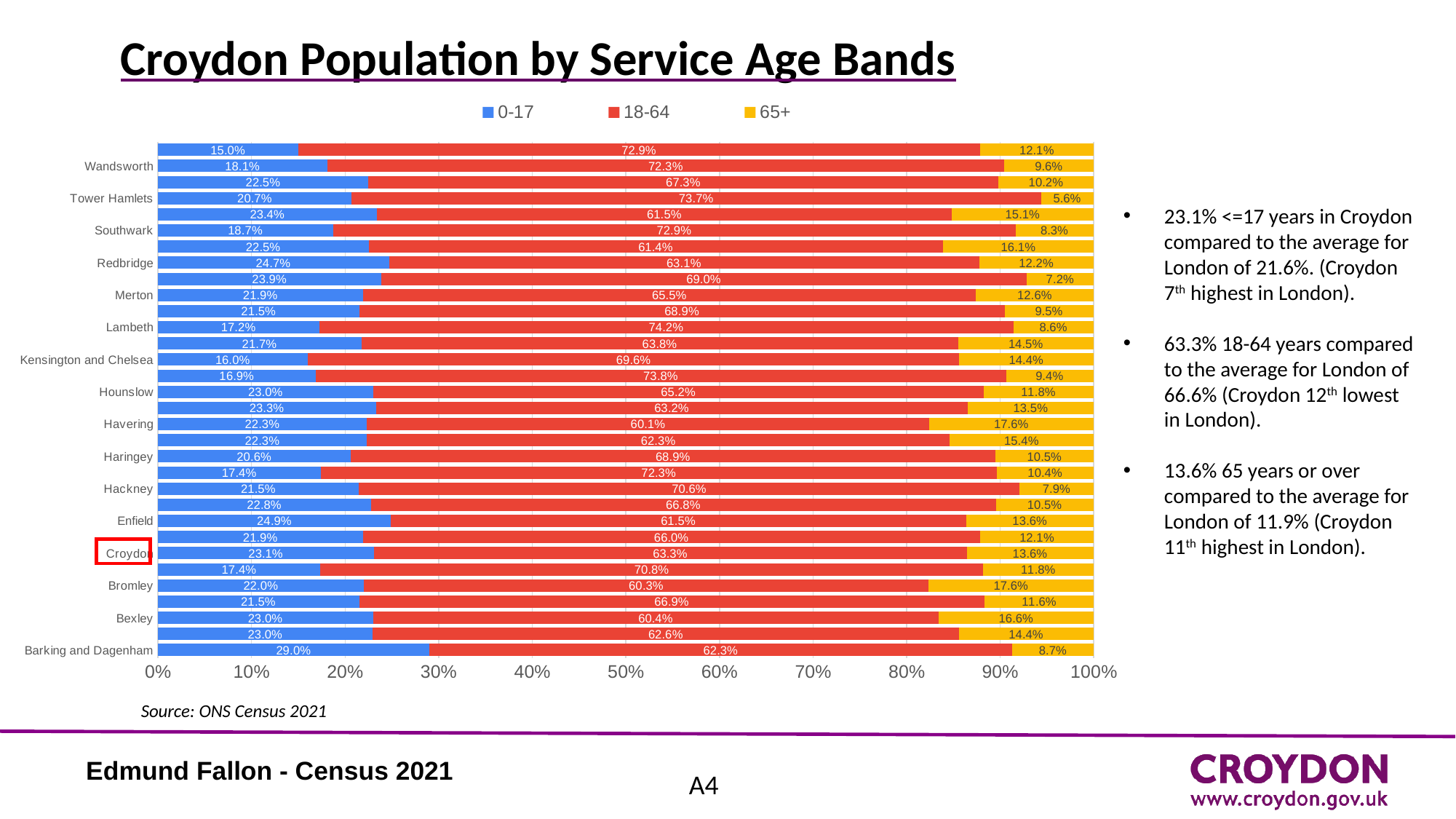
Which borough has the highest 0-17 share? Barking and Dagenham What is the difference between the 0-17 values for Enfield and Kensington and Chelsea? 8.9% Which series is shown in yellow in the legend? 65+ What is the difference between the 65+ values for Bexley and Hackney? 8.7% What is the 65+ value for Havering? 17.6% Which borough has the lowest 65+ share? Tower Hamlets What is the 0-17 value for Croydon? 23.1% What is the 0-17 value for Barking and Dagenham? 29.0% What is the 18-64 value for Tower Hamlets? 73.7% What kind of chart is shown on the slide? Stacked bar chart How many series does the legend list? 3 Which has a larger 18-64 share, Lambeth or Bromley? Lambeth